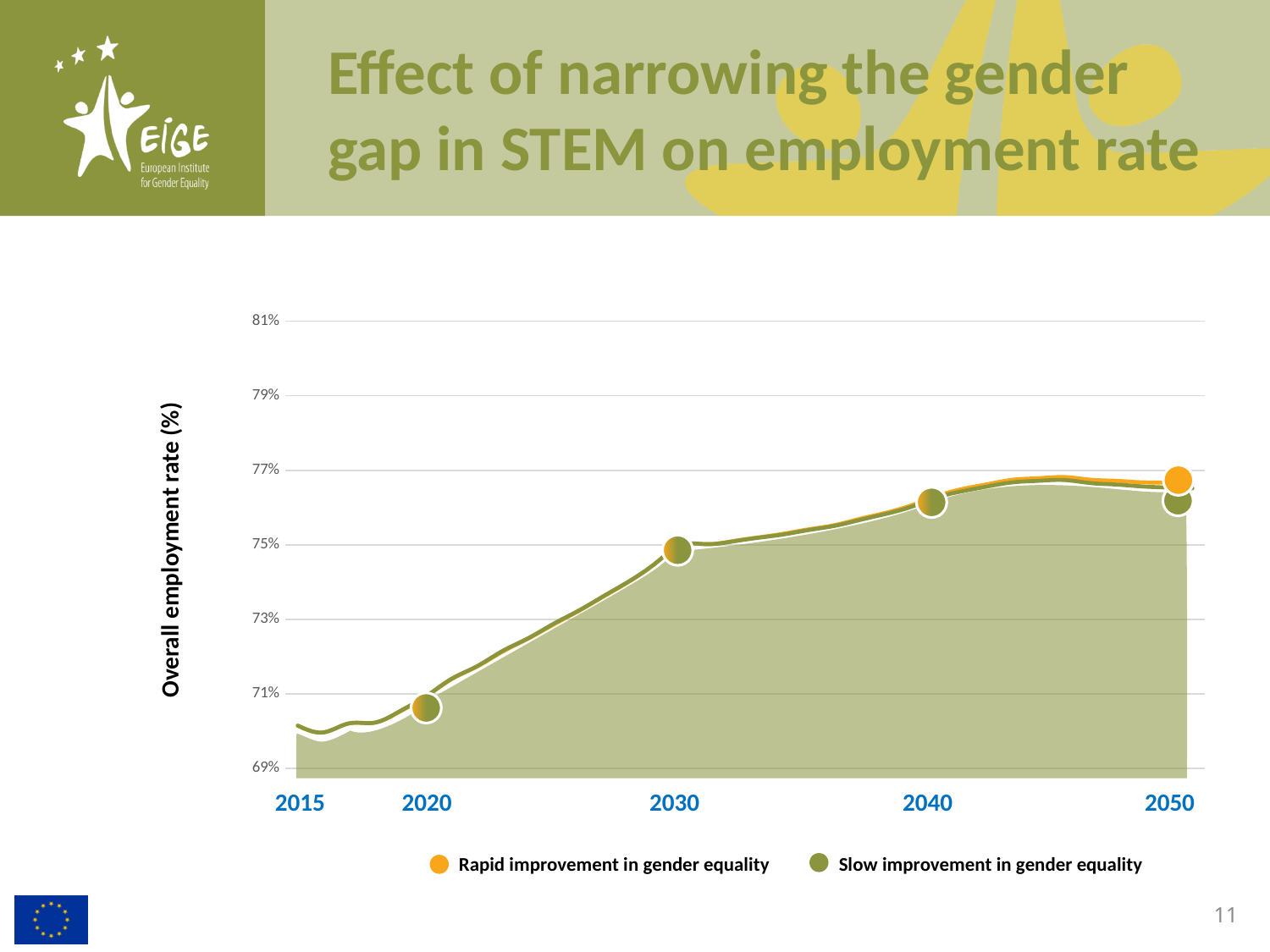
How many series does the legend list? 2 What kind of chart is shown on the slide? line chart Does the overall employment rate rise or fall between 2015 and 2040? rise Is the value for 2040 greater or less than 75%? greater Is the 2050 value for Rapid improvement in gender equality greater or less than 77%? less In 2050, which series has the higher employment rate, Rapid improvement or Slow improvement in gender equality? Rapid improvement in gender equality What is the label on the vertical axis? Overall employment rate (%) Which labelled year has the lowest overall employment rate? 2015 Is the value for 2015 greater or less than 71%? less How many years are labelled on the x axis? 5 What are the two series named in the legend? Rapid improvement in gender equality; Slow improvement in gender equality